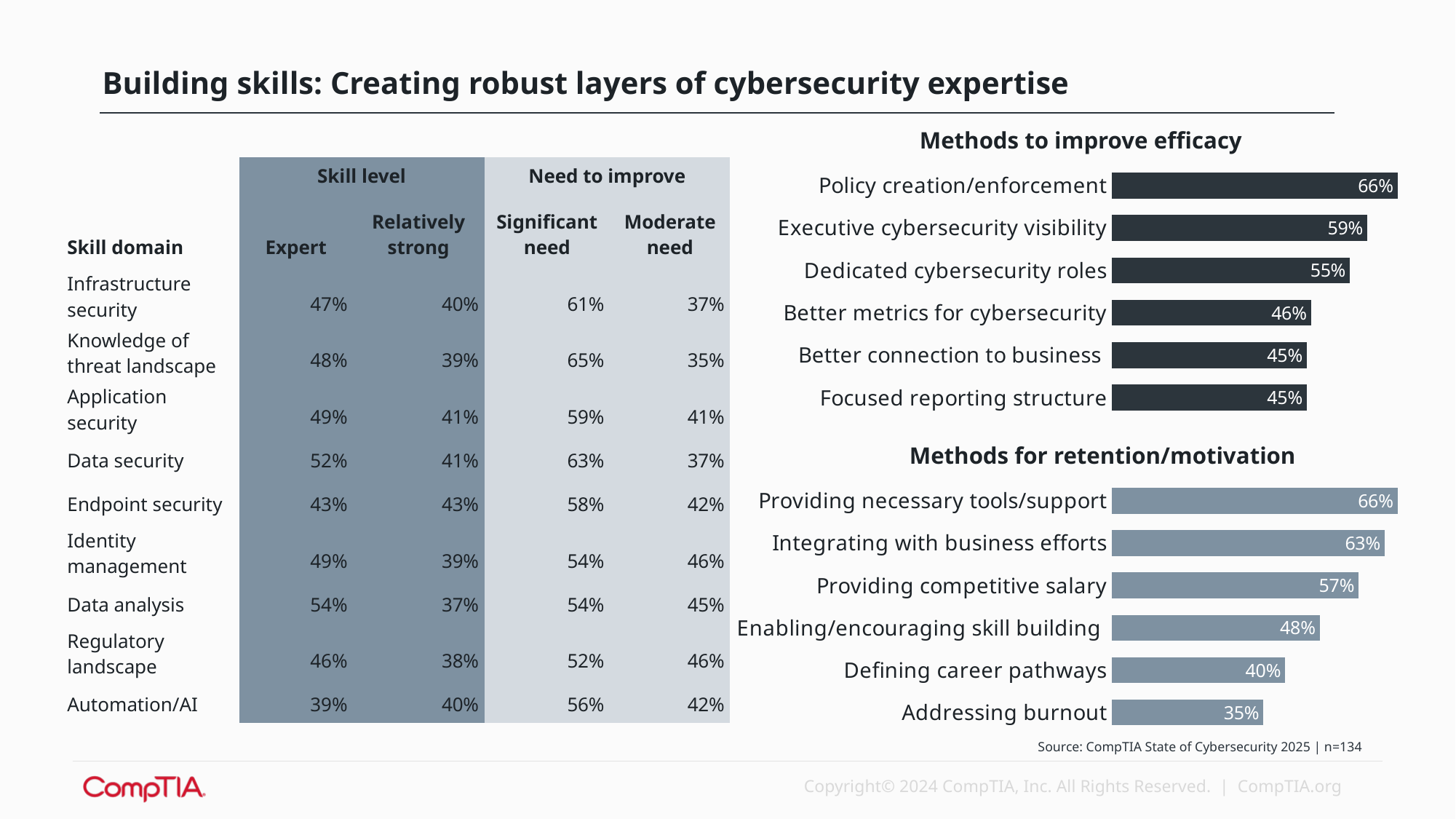
What kind of chart is 'Methods for retention/motivation'? Horizontal bar chart In the 'Methods to improve efficacy' chart, how many methods are shown? 6 In the 'Methods for retention/motivation' chart, which method has the highest value? Providing necessary tools/support In the 'Methods for retention/motivation' chart, which is larger: Defining career pathways or Enabling/encouraging skill building? Enabling/encouraging skill building In the 'Methods for retention/motivation' chart, what is the value for Providing competitive salary? 57% In the 'Methods to improve efficacy' chart, what is the value for Policy creation/enforcement? 66% In the 'Methods for retention/motivation' chart, what is the difference between Integrating with business efforts and Addressing burnout? 28 percentage points In the 'Methods to improve efficacy' chart, what is the difference between Policy creation/enforcement and Dedicated cybersecurity roles? 11 percentage points In the 'Methods to improve efficacy' chart, what is the value for Better metrics for cybersecurity? 46% In the 'Methods to improve efficacy' chart, which method has the lowest value? Better connection to business and Focused reporting structure (both 45%) In the 'Methods for retention/motivation' chart, which method has the lowest value? Addressing burnout Do the values in the 'Methods to improve efficacy' chart rise or fall from top to bottom? Fall